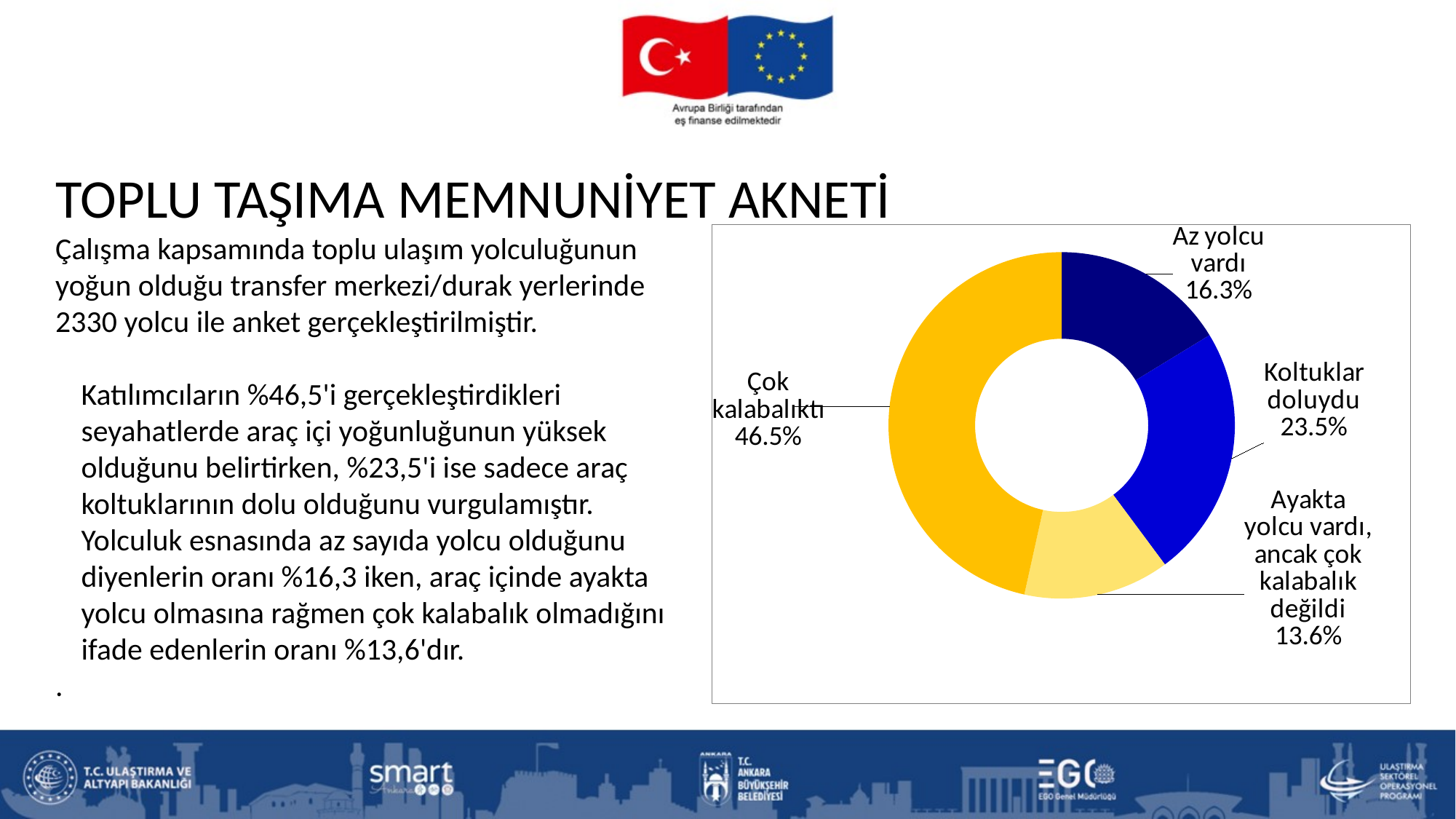
Which category has the largest slice in the pie chart? Çok kalabalıktı What percentage is shown for "Az yolcu vardı" in the pie chart? 16.3% What share of the pie chart is labelled "Çok kalabalıktı"? 46.5% What is the difference in percentage points between "Çok kalabalıktı" and "Koltuklar doluydu"? 23 percentage points What colour is the "Çok kalabalıktı" slice in the pie chart? Yellow/orange Which category has the smallest slice in the pie chart? Ayakta yolcu vardı, ancak çok kalabalık değildi What percentage is shown for "Ayakta yolcu vardı, ancak çok kalabalık değildi" in the pie chart? 13.6% Which is larger in the pie chart: "Koltuklar doluydu" or "Az yolcu vardı"? Koltuklar doluydu What type of chart is shown on the slide? Pie chart (donut) What is the difference in percentage points between "Az yolcu vardı" and "Ayakta yolcu vardı, ancak çok kalabalık değildi"? 2.7 percentage points What percentage is shown for "Koltuklar doluydu" in the pie chart? 23.5% How many slices does the pie chart have? 4